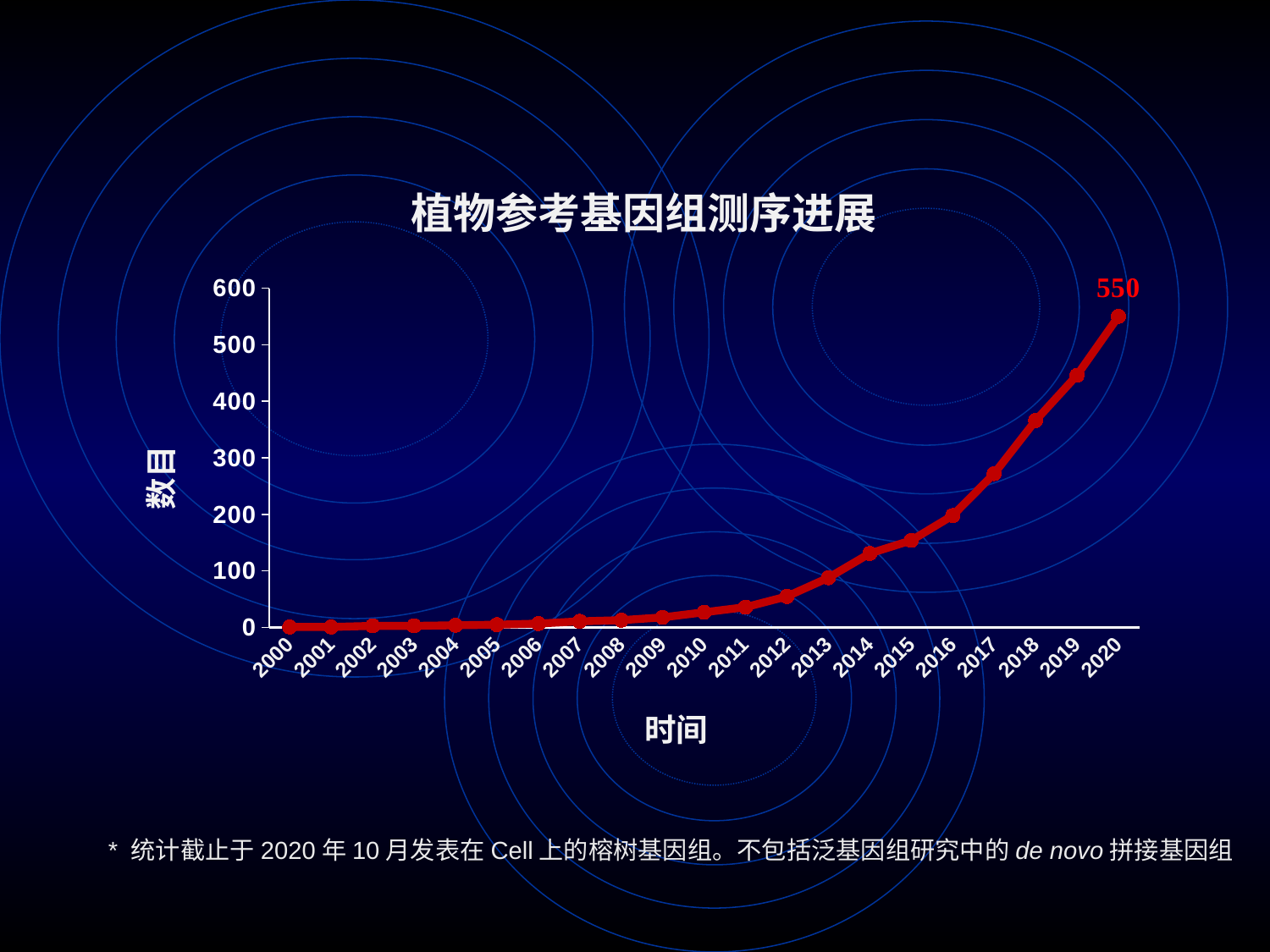
Is the value for 2017 greater or less than 300? less Do the values rise or fall from 2000 to 2020? rise Which year has the highest value on the chart? 2020 How many data points are plotted on the line? 21 Is the value for 2018 greater or less than 300? greater What kind of chart is shown on the slide? line chart What is the value plotted for 2020? 550 What is the title of the chart? 植物参考基因组测序进展 Is the value for 2019 greater or less than 400? greater What is the label on the y axis? 数目 Which year has the larger value, 2015 or 2019? 2019